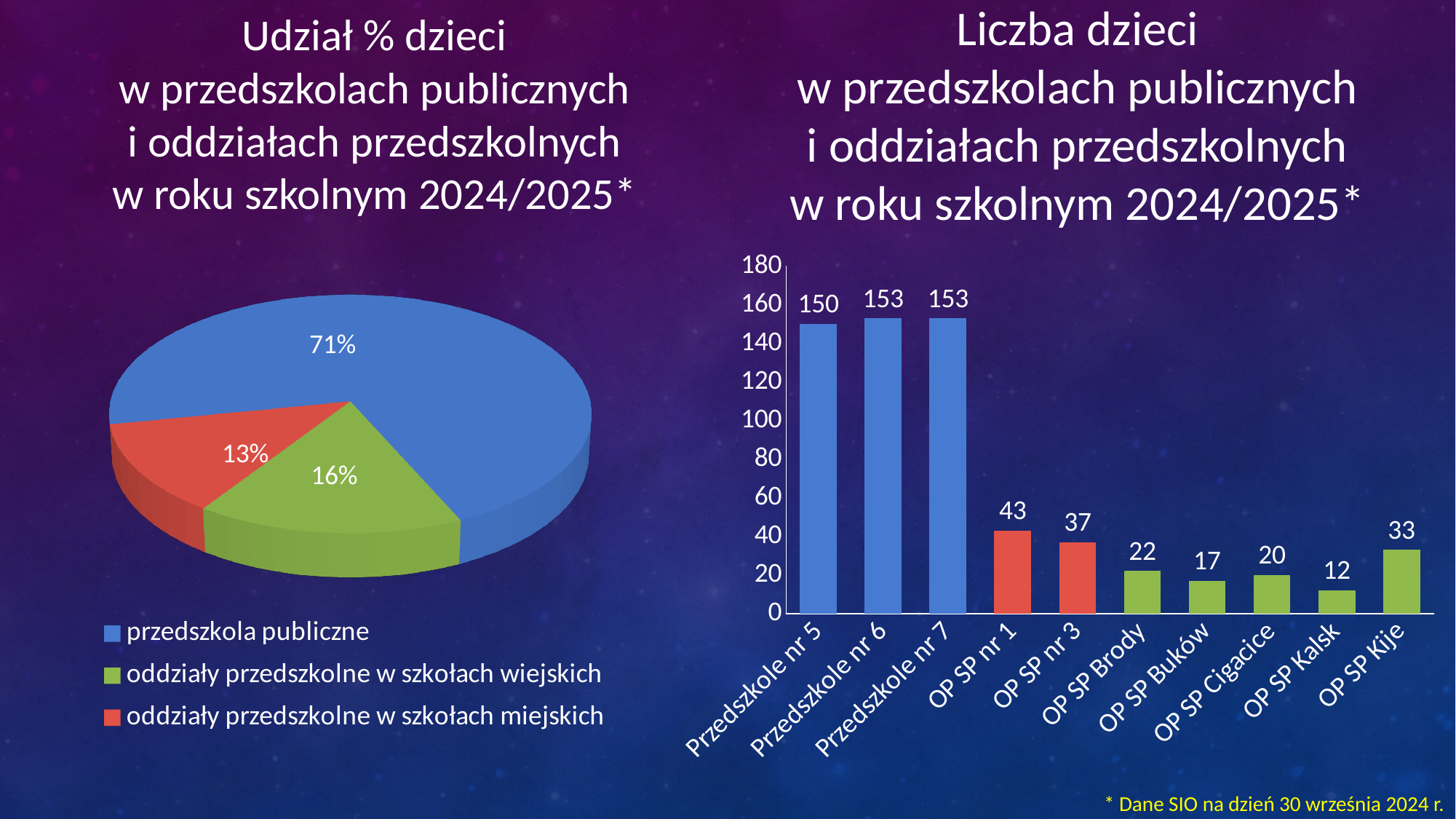
In the right bar chart, how many children are in OP SP Kije? 33 In the left pie chart, which category has the smallest share? oddziały przedszkolne w szkołach miejskich In the left pie chart, what share is shown for oddziały przedszkolne w szkołach miejskich? 13% In the right bar chart, which category has the lowest value? OP SP Kalsk In the right bar chart, which is larger: OP SP Brody or OP SP Cigacice? OP SP Brody In the right bar chart, how many children are in Przedszkole nr 5? 150 In the left pie chart, how many slices does the pie have? 3 What kind of chart is the chart on the right side of the slide? bar chart In the left pie chart, what share of children is in przedszkola publiczne? 71% In the right bar chart, what is the difference between OP SP nr 1 and OP SP nr 3? 6 In the right bar chart, how many categories are shown on the x axis? 10 In the left pie chart, what share is shown for oddziały przedszkolne w szkołach wiejskich? 16%